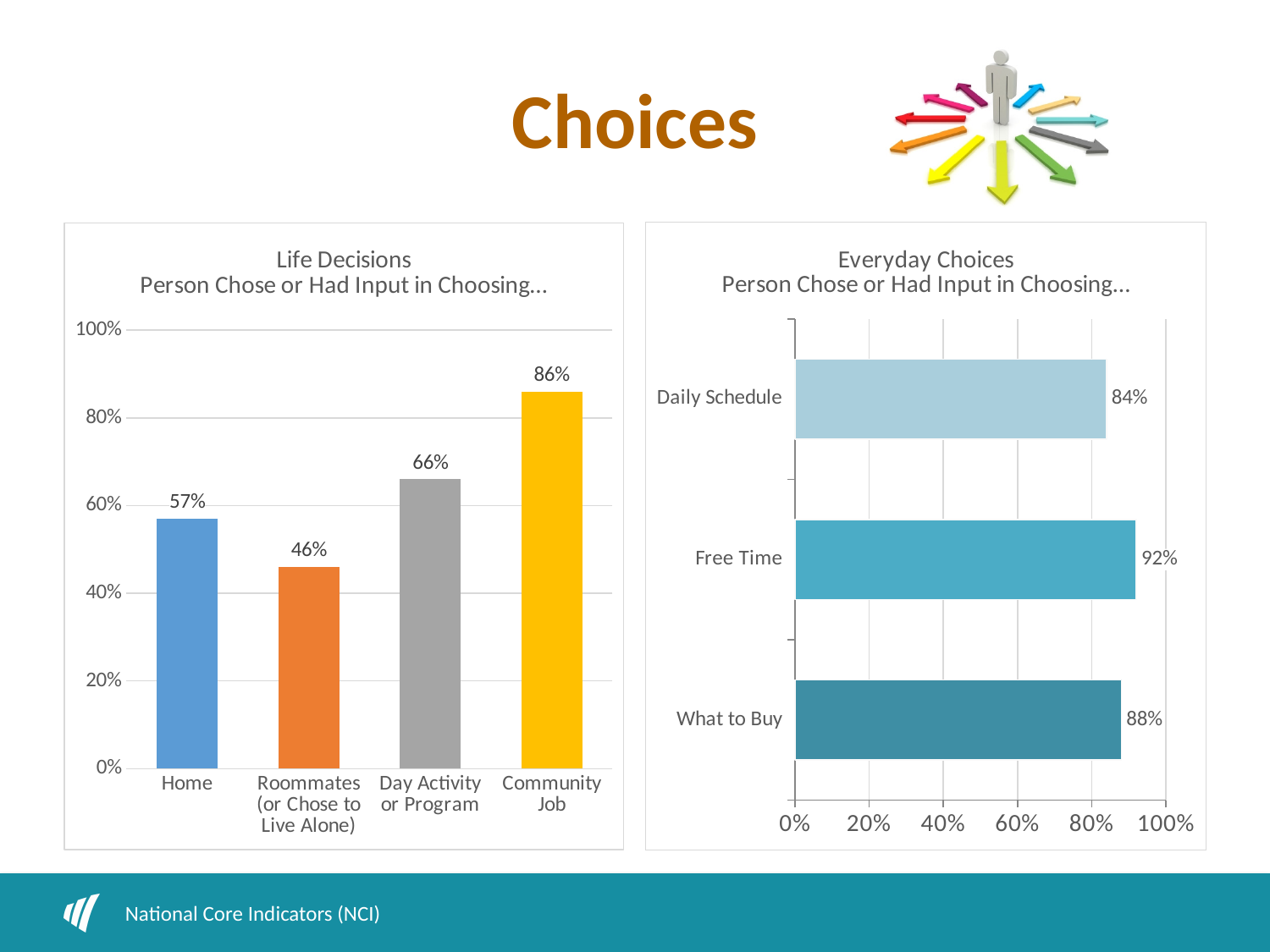
In the Everyday Choices chart, what is the value for Free Time? 92% In the Everyday Choices chart, which category has the lowest value? Daily Schedule In the Life Decisions chart, what is the value for Roommates (or Chose to Live Alone)? 46% In the Life Decisions chart, what is the value for Home? 57% In the Life Decisions chart, which category has the lowest value? Roommates (or Chose to Live Alone) What kind of chart is the Everyday Choices chart? Bar chart In the Life Decisions chart, what is the difference between Community Job and Day Activity or Program? 20% In the Life Decisions chart, which category has the highest value? Community Job In the Everyday Choices chart, what is the difference between Free Time and Daily Schedule? 8% In the Everyday Choices chart, what is the value for What to Buy? 88% In the Everyday Choices chart, which is larger, Free Time or Daily Schedule? Free Time In the Life Decisions chart, how many categories are shown? 4